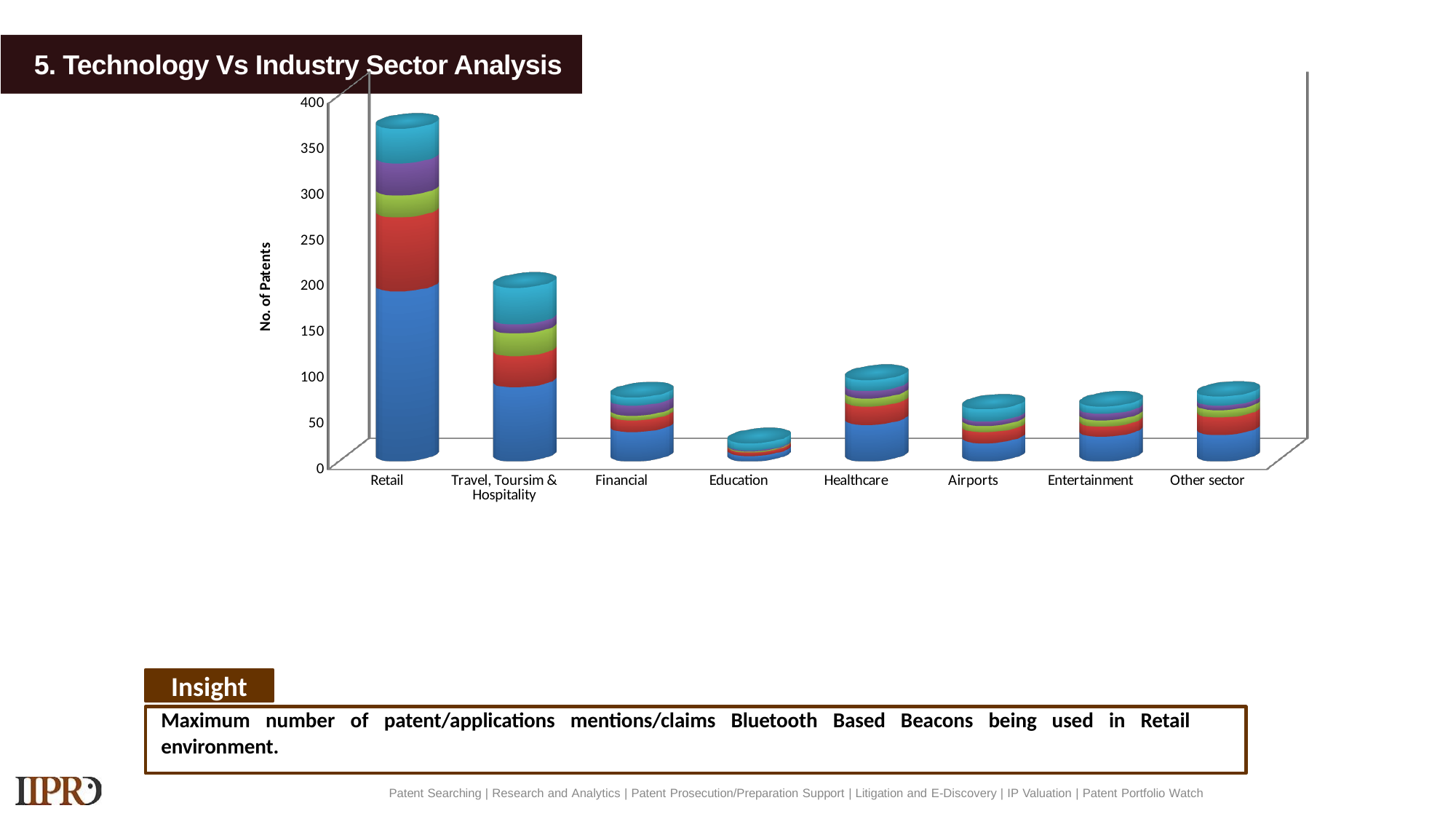
Is the total value for Financial greater or less than 100? less Which has a larger total number of patents, Healthcare or Financial? Healthcare Which industry sector has the lowest total number of patents? Education Which industry sector has the highest total number of patents? Retail Is the total value for Healthcare greater or less than 150? less What is the label of the vertical axis of the chart? No. of Patents Is the total value for Travel, Toursim & Hospitality greater or less than 150? greater Which has a larger total number of patents, Travel, Toursim & Hospitality or Healthcare? Travel, Toursim & Hospitality How many industry sector categories are shown on the x axis? 8 What kind of chart is shown on the slide? Stacked bar chart